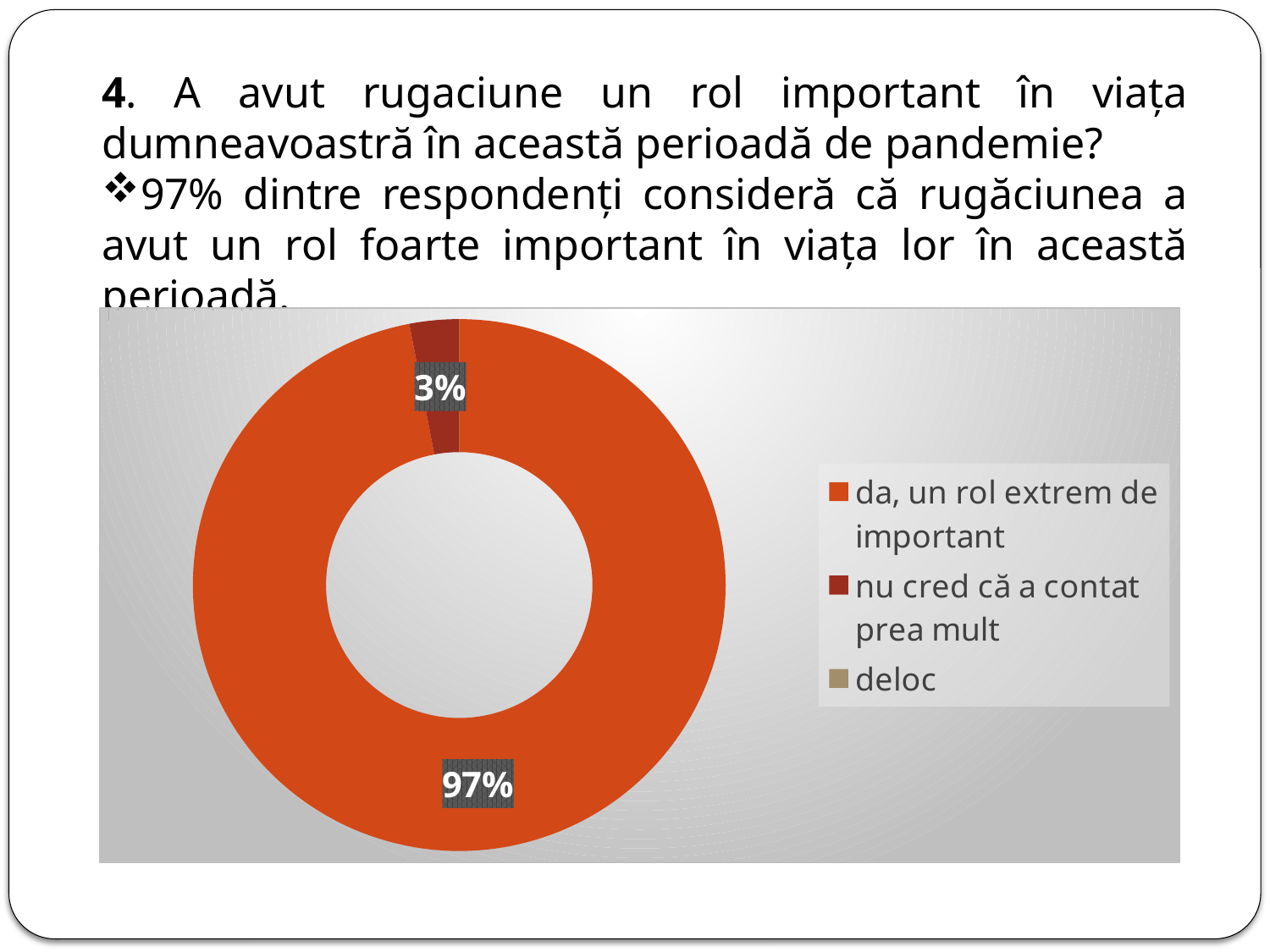
What share of the chart does the orange slice represent? 97% Which response category has the largest share of the chart? da, un rol extrem de important How many slices in the chart carry a printed data label? 2 Which legend entry is listed last? deloc What percentage of respondents answered "nu cred că a contat prea mult"? 3% What kind of chart is shown on the slide? Doughnut (pie) chart What colour is the slice for "nu cred că a contat prea mult"? Dark red What percentage of respondents answered "da, un rol extrem de important"? 97% How many entries does the chart legend list? 3 By how many percentage points does "da, un rol extrem de important" exceed "nu cred că a contat prea mult"? 94 percentage points Which of the two labelled slices is the smallest? nu cred că a contat prea mult Which is larger: the share for "da, un rol extrem de important" or for "nu cred că a contat prea mult"? da, un rol extrem de important